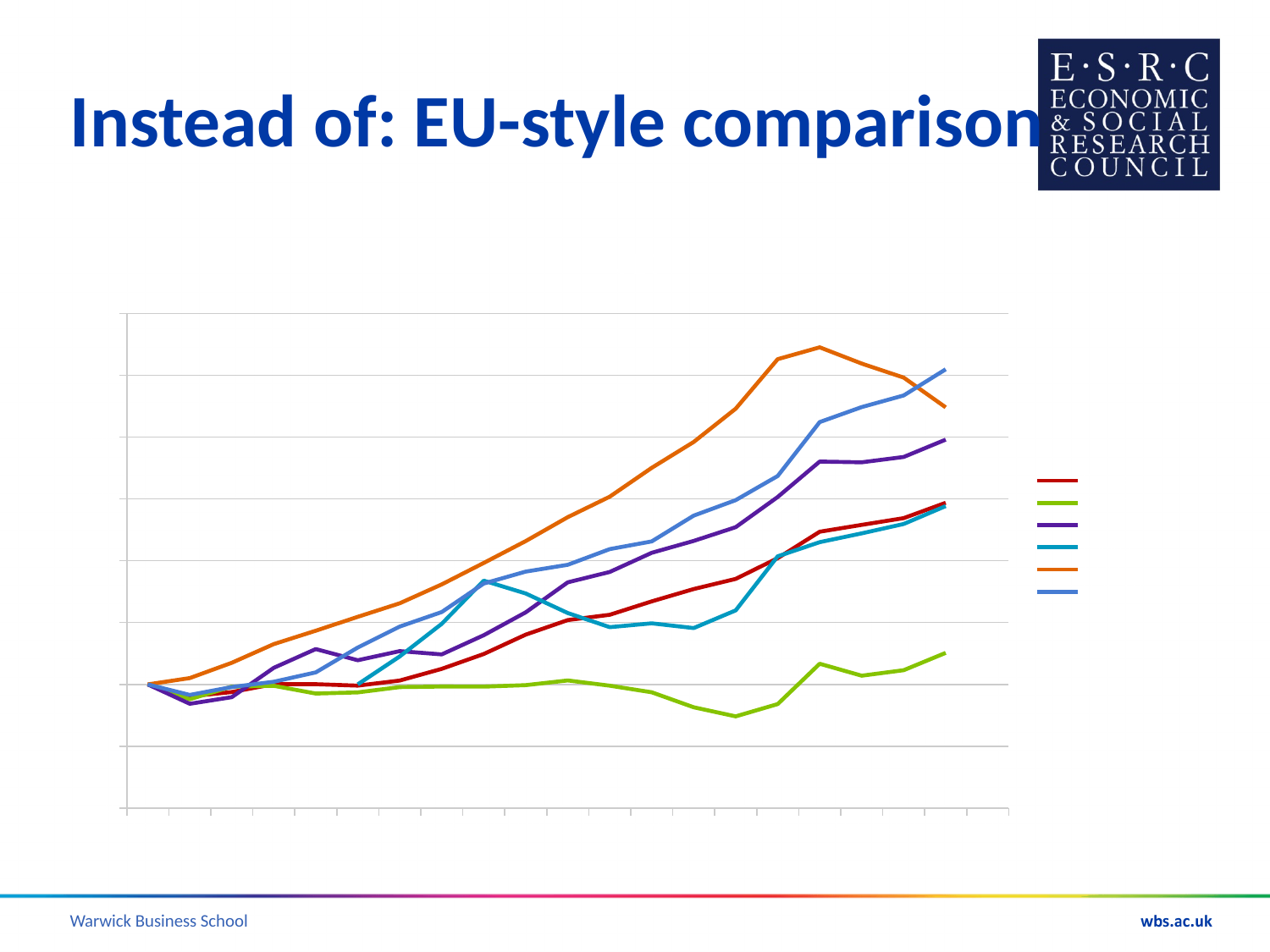
Do all the lines start from the same point at the left of the chart? no Which coloured line is highest at the right-hand end of the chart? light blue What is the title of the slide containing the chart? Instead of: EU-style comparison Which coloured line stays lowest across the chart? green At the right-hand end of the chart, is the purple line above or below the orange line? below What kind of chart is shown on the slide? line chart At the right-hand end of the chart, which is higher, the red line or the green line? red Does the orange line generally rise or fall from left to right? rise Which coloured line reaches the highest point on the chart? orange How many series does the legend list? 6 Does the light blue line generally rise or fall from left to right? rise